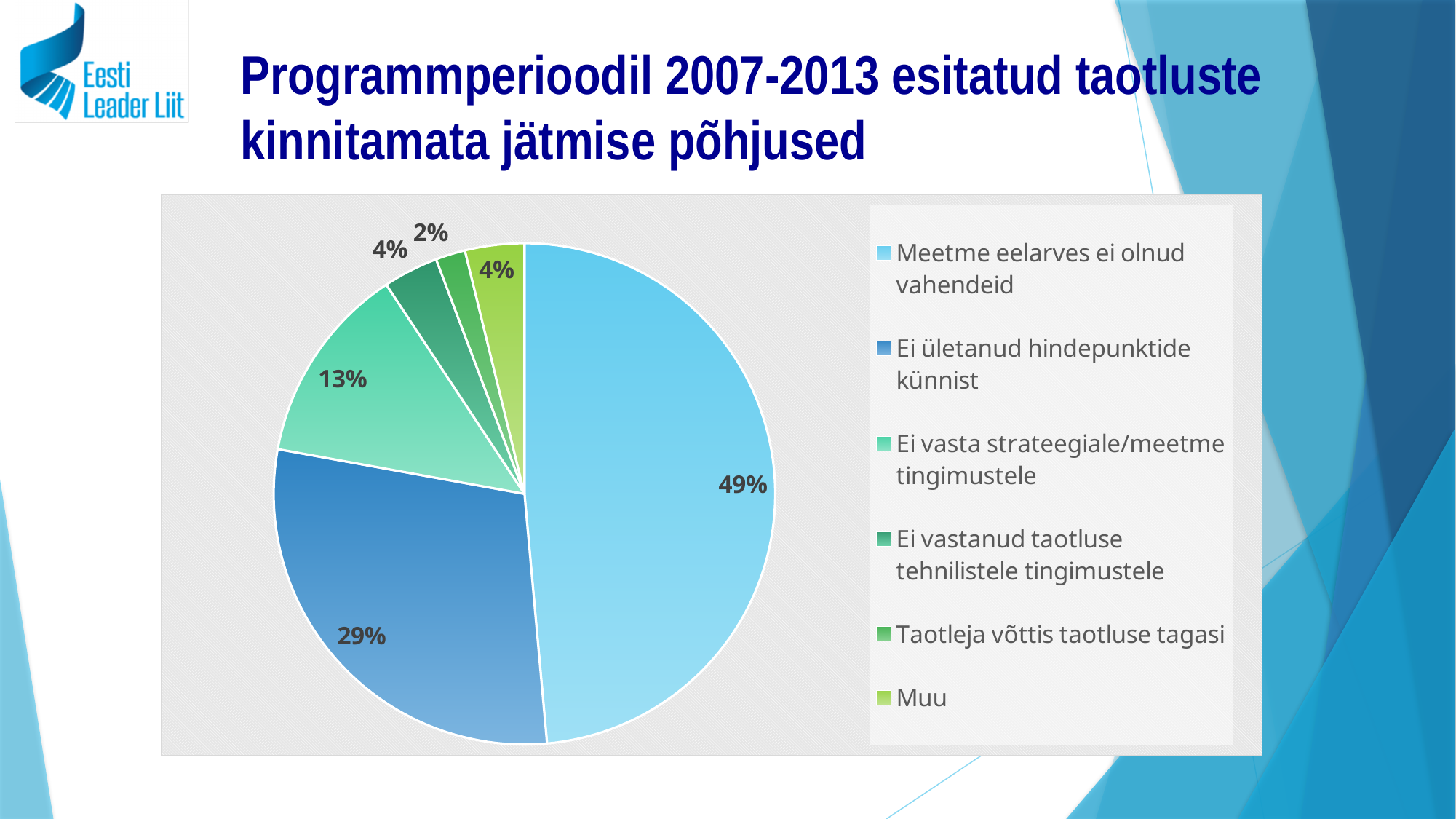
What share of the pie does "Meetme eelarves ei olnud vahendeid" represent? 49% What is the value shown for "Ei ületanud hindepunktide künnist"? 29% How many categories does the pie chart show? 6 What percentage is labelled for "Ei vasta strateegiale/meetme tingimustele"? 13% Which category has the largest slice of the pie? Meetme eelarves ei olnud vahendeid What is the title of the slide containing the chart? Programmperioodil 2007-2013 esitatud taotluste kinnitamata jätmise põhjused What share of the pie is "Muu"? 4% Which category has the smallest slice of the pie? Taotleja võttis taotluse tagasi Which is larger: "Ei vasta strateegiale/meetme tingimustele" or "Ei vastanud taotluse tehnilistele tingimustele"? Ei vasta strateegiale/meetme tingimustele What is the value for "Taotleja võttis taotluse tagasi"? 2% What is the difference in percentage points between "Meetme eelarves ei olnud vahendeid" and "Ei ületanud hindepunktide künnist"? 20 What type of chart is shown on the slide? Pie chart